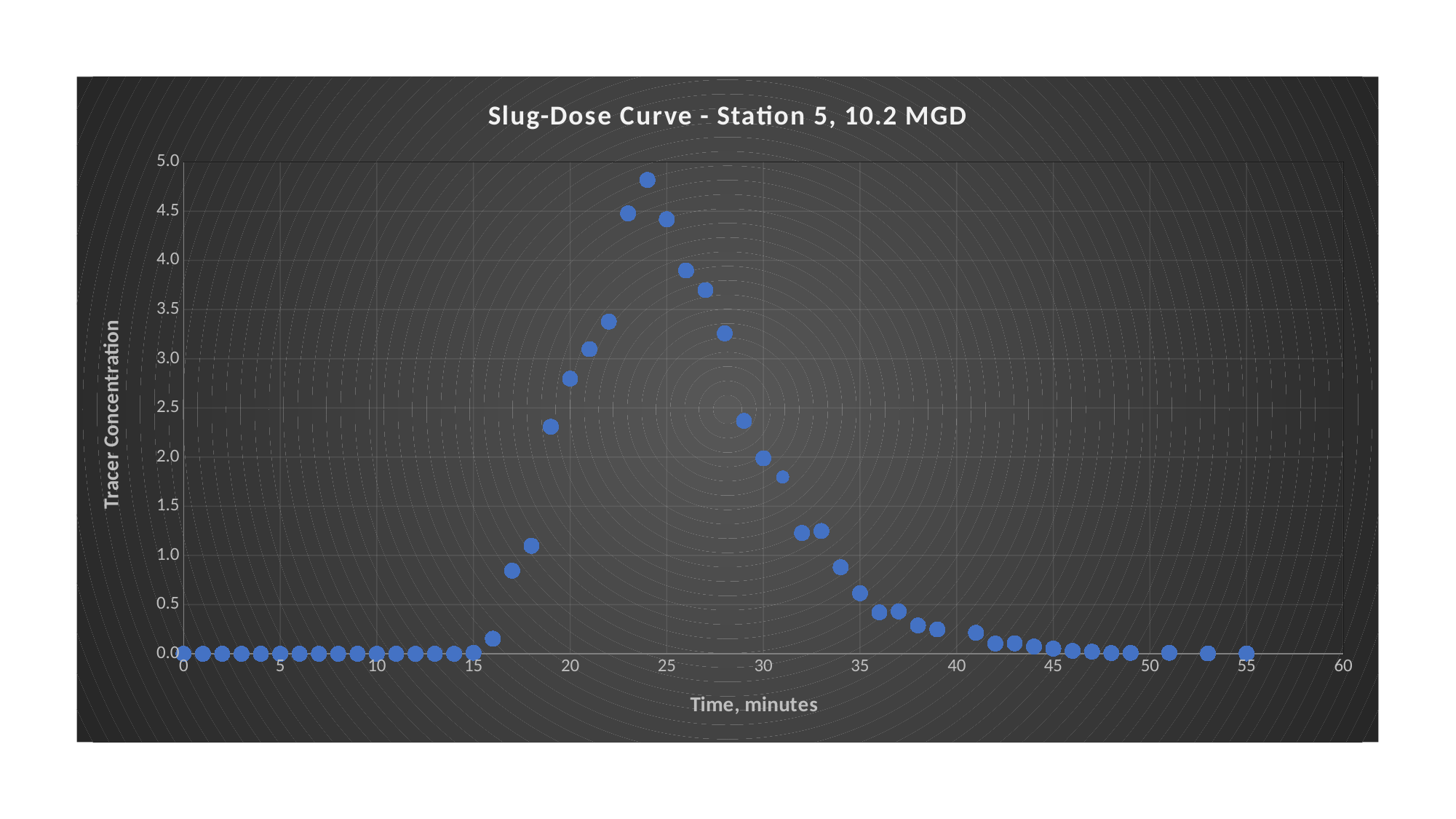
Is the tracer concentration at 31 minutes greater or less than 2.0? less What is the label of the x axis? Time, minutes What kind of chart is shown on the slide? Scatter chart What is the tracer concentration at 5 minutes? 0.0 Is the tracer concentration at 24 minutes greater or less than 4.5? greater Which has the higher tracer concentration, 20 minutes or 30 minutes? 20 minutes Is the tracer concentration at 28 minutes greater or less than 3.0? greater At what time, in minutes, does the tracer concentration reach its highest value? 24 Between 24 and 45 minutes, does the tracer concentration rise or fall as time increases? Fall What is the title of the chart? Slug-Dose Curve - Station 5, 10.2 MGD